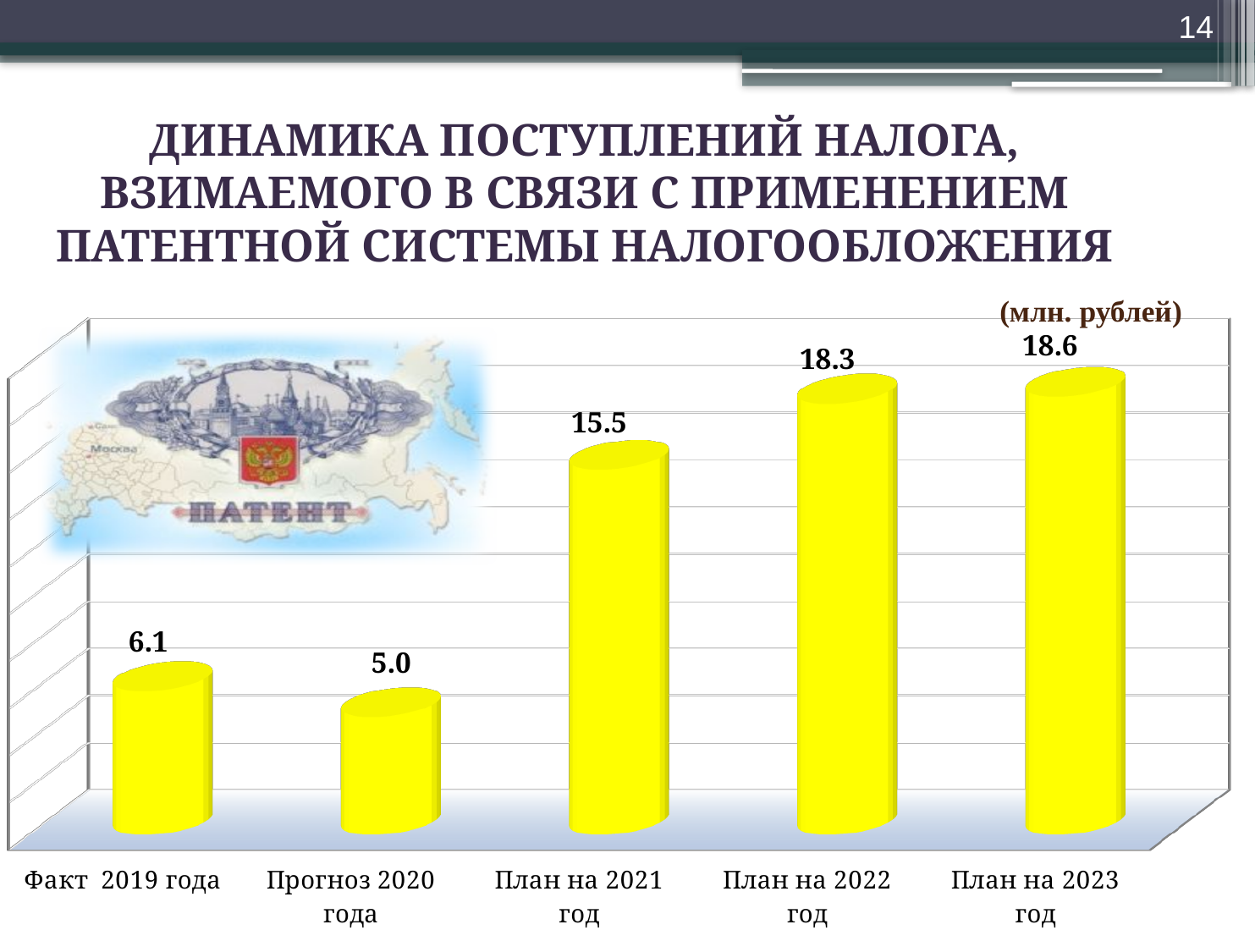
Which category has the lowest value? Прогноз 2020 года What is the difference between the values for Факт 2019 года and Прогноз 2020 года? 1.1 What is the value for План на 2023 год? 18.6 How many categories are shown on the chart? 5 What is the difference between the values for План на 2022 год and План на 2021 год? 2.8 What is the value for Факт 2019 года? 6.1 What is the value for Прогноз 2020 года? 5.0 In what units are the values on the chart given? млн. рублей Which category has the highest value? План на 2023 год What is the value for План на 2021 год? 15.5 Which is larger, the value for Факт 2019 года or the value for Прогноз 2020 года? Факт 2019 года What kind of chart is shown on the slide? bar chart